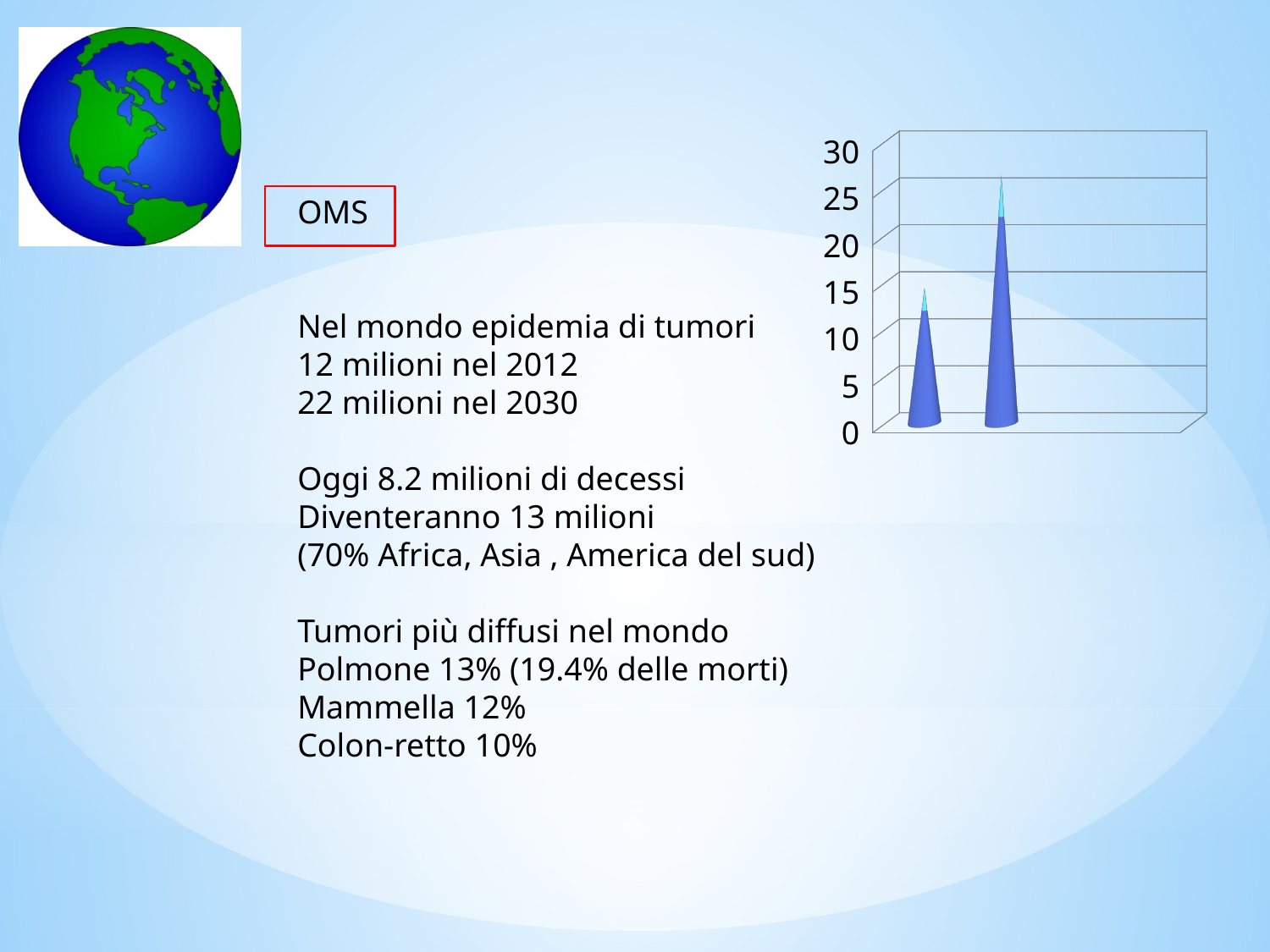
Is the value of the right bar in the chart greater or less than 30? less What kind of chart is shown on the right of the slide? bar chart Is the value of the left bar in the chart greater or less than 20? less How many bars are plotted in the chart? 2 What is the step between consecutive tick labels on the vertical axis of the chart? 5 Do the bar values rise or fall from left to right in the chart? rise Which bar in the chart has the lowest value? the left bar Is the value of the right bar in the chart greater or less than 20? greater What is the highest value shown on the vertical axis of the chart? 30 Which bar is taller in the chart, the left one or the right one? the right one Which bar in the chart has the highest value? the right bar